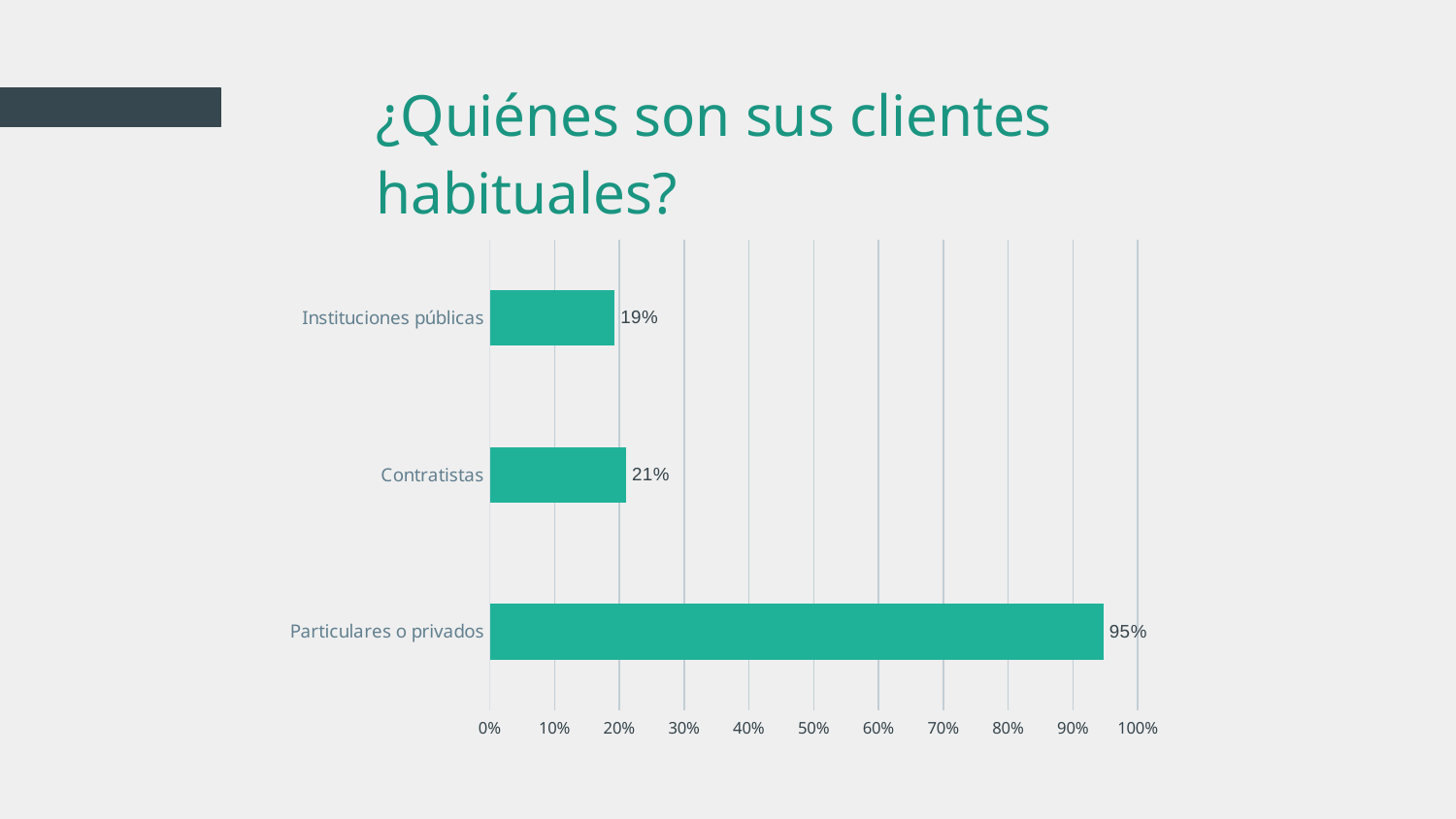
What is the value for Contratistas? 21% What kind of chart is shown on the slide? bar chart What is the value for Instituciones públicas? 19% How many categories are shown in the chart? 3 What is the difference between the values for Contratistas and Instituciones públicas? 2% Which is larger, the value for Particulares o privados or the value for Instituciones públicas? Particulares o privados What is the value for Particulares o privados? 95% Which category has the lowest value? Instituciones públicas What is the title of the chart? ¿Quiénes son sus clientes habituales? What is the difference between the values for Particulares o privados and Contratistas? 74% Is the value for Particulares o privados greater or less than 90%? greater Which category has the highest value? Particulares o privados